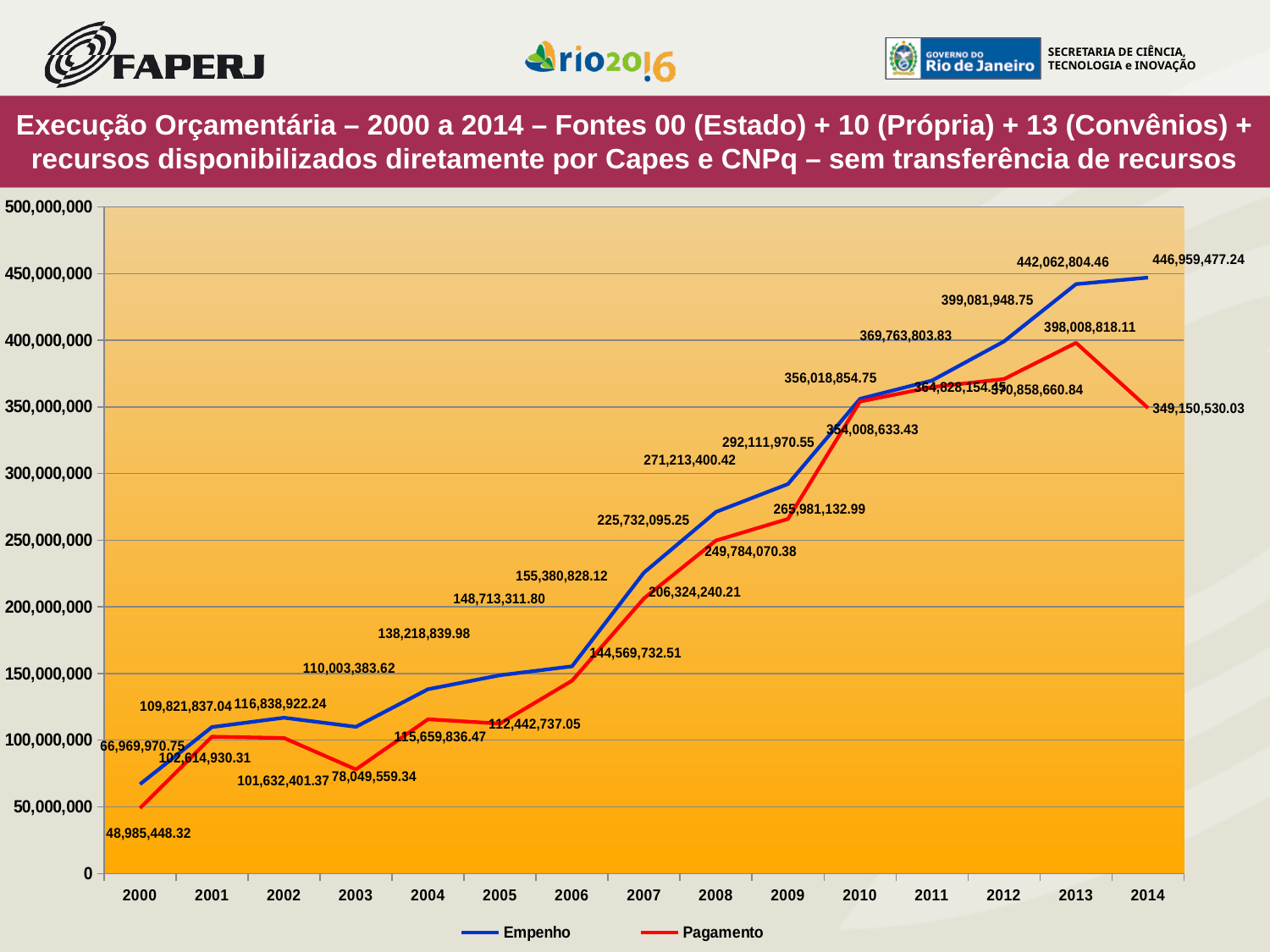
How many years are plotted along the x axis? 15 In which year is the Empenho value highest? 2014 Is the Pagamento value for 2003 greater or less than 100,000,000? less In which year is the Pagamento value lowest? 2000 How many series does the legend list? 2 In 2014, which series has the larger value, Empenho or Pagamento? Empenho What is the difference between the Empenho and Pagamento values in 2014? 97,808,947.21 What is the Empenho value for 2013? 442,062,804.46 What kind of chart is shown on the slide? Line chart What is the Pagamento value for 2000? 48,985,448.32 What is the Empenho value for 2014? 446,959,477.24 What colour is the Pagamento line in the legend? Red